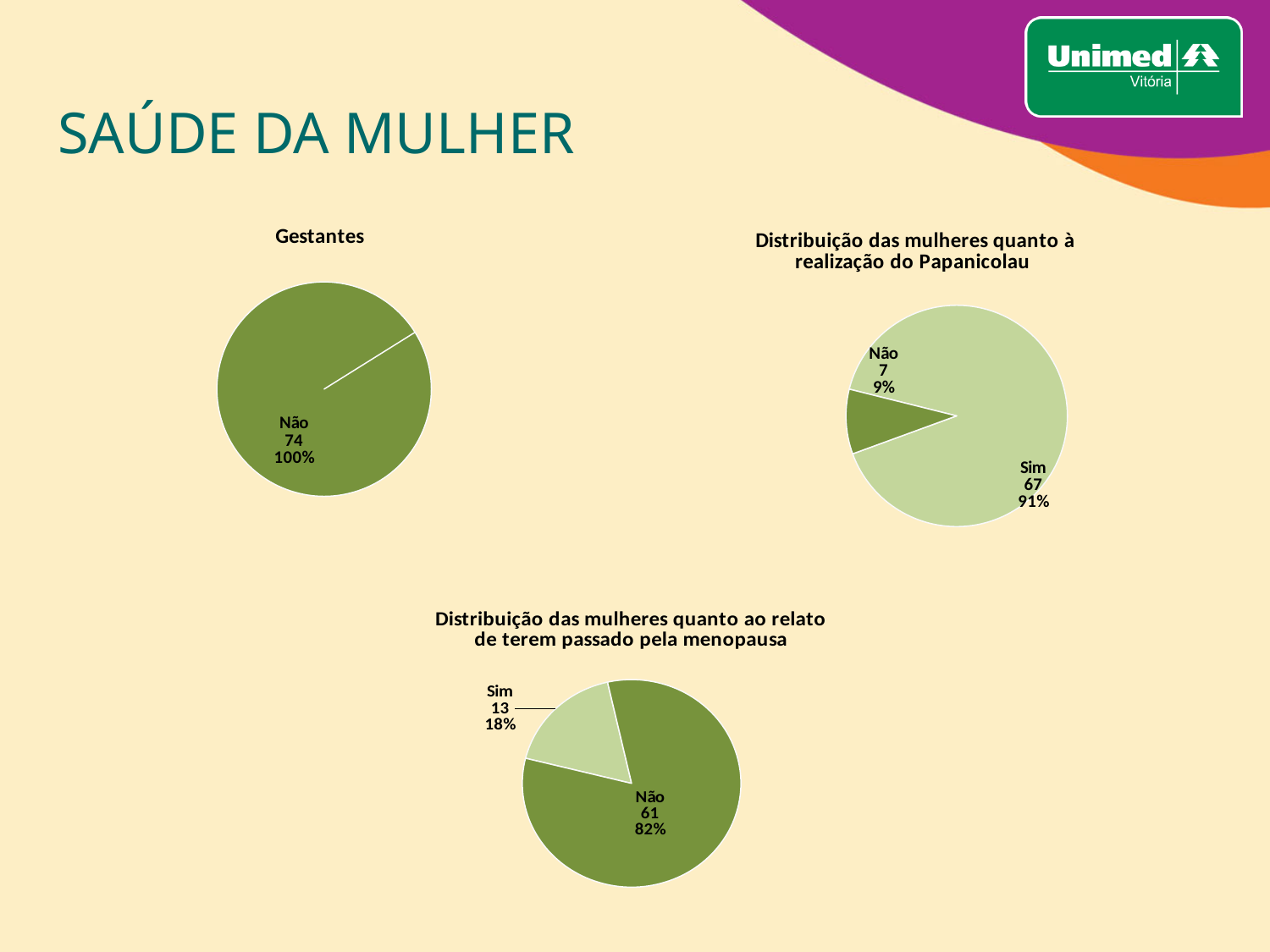
What kind of chart is the 'Gestantes' chart? Pie chart In the 'Distribuição das mulheres quanto à realização do Papanicolau' chart, what is the value for 'Não'? 7 How many slices are labelled in the 'Distribuição das mulheres quanto ao relato de terem passado pela menopausa' chart? 2 In the 'Gestantes' chart, what percentage share does the 'Não' slice have? 100% In the 'Distribuição das mulheres quanto à realização do Papanicolau' chart, which category is the largest? Sim In the 'Gestantes' chart, what is the value for 'Não'? 74 In the 'Distribuição das mulheres quanto ao relato de terem passado pela menopausa' chart, which category is the smallest? Sim In the 'Distribuição das mulheres quanto ao relato de terem passado pela menopausa' chart, what is the value for 'Sim'? 13 In the 'Distribuição das mulheres quanto ao relato de terem passado pela menopausa' chart, what share of the pie is 'Não'? 82% In the 'Distribuição das mulheres quanto à realização do Papanicolau' chart, what is the value for 'Sim'? 67 In the 'Distribuição das mulheres quanto à realização do Papanicolau' chart, what is the difference between 'Sim' and 'Não'? 60 In the 'Distribuição das mulheres quanto à realização do Papanicolau' chart, what share of the pie is 'Não'? 9%